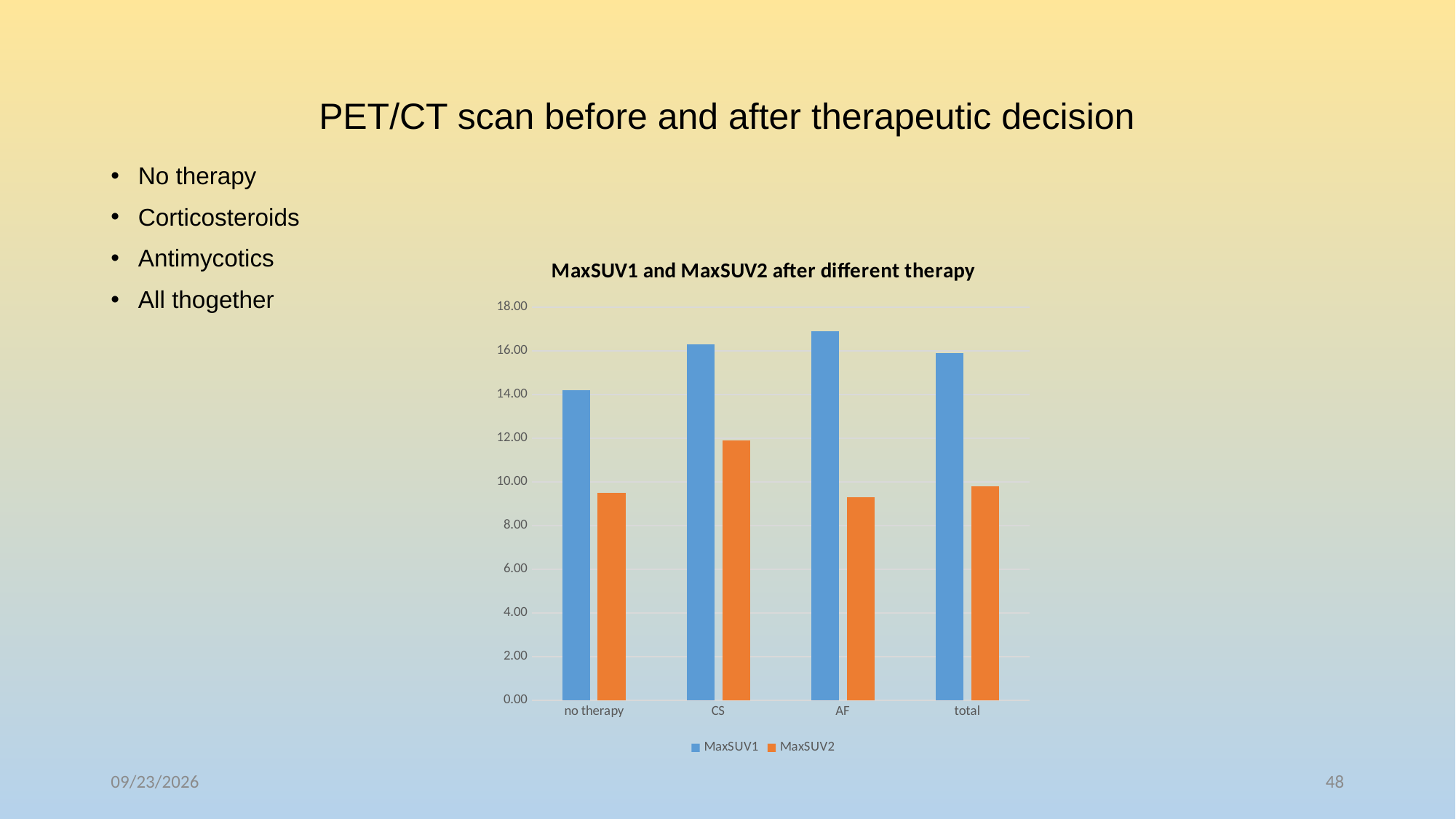
What is the title of the chart? MaxSUV1 and MaxSUV2 after different therapy Is the MaxSUV2 value for AF greater or less than 10.00? less How many series does the chart legend list? 2 How many categories are shown on the x axis of the chart? 4 Which category has the highest MaxSUV2 value? CS Is the MaxSUV2 value for CS greater or less than 10.00? greater Which is larger, the MaxSUV2 value for CS or the MaxSUV2 value for total? CS Which category has the lowest MaxSUV1 value? no therapy Is the MaxSUV1 value for AF greater or less than 16.00? greater For the CS category, which is larger, MaxSUV1 or MaxSUV2? MaxSUV1 What kind of chart is shown on the slide? bar chart Which category has the highest MaxSUV1 value? AF